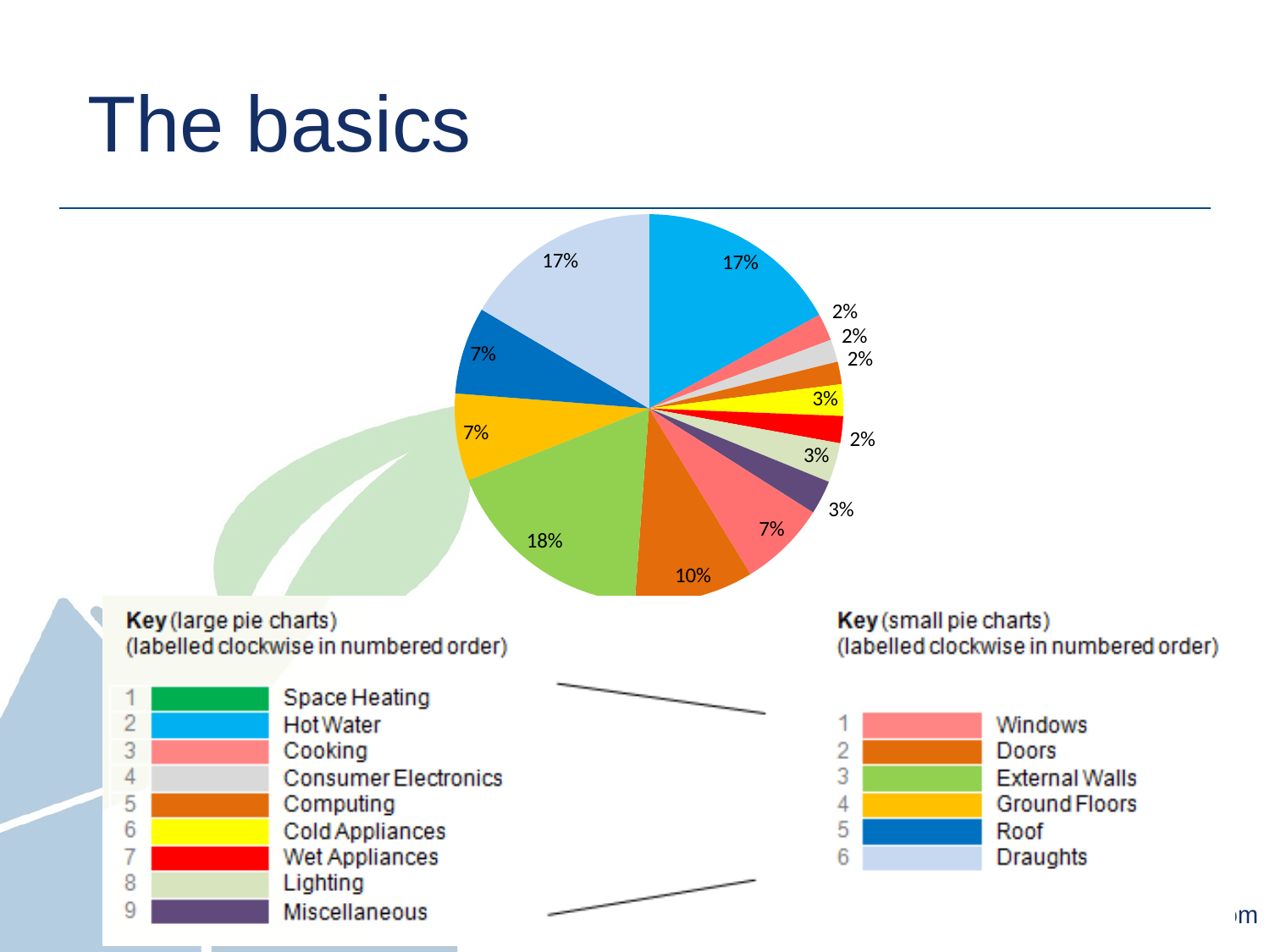
How many entries are listed in the key for the small pie charts? 6 What is the smallest percentage shown on the pie chart? 2% What is the difference in percentage points between the green slice (18%) and the dark orange slice (10%)? 8 Which is larger, the green slice or the bright blue slice at the top of the pie chart? the green slice What is the largest percentage shown on the pie chart? 18% How many slices of the pie chart are labelled 17%? 2 How many entries are listed in the key for the large pie charts? 9 What percentage is shown on the green slice of the pie chart? 18% What kind of chart is shown on the slide? pie chart What percentage is shown on the dark orange slice at the bottom of the pie chart? 10% How many slices does the pie chart have? 14 What percentage is shown on the dark blue slice of the pie chart? 7%